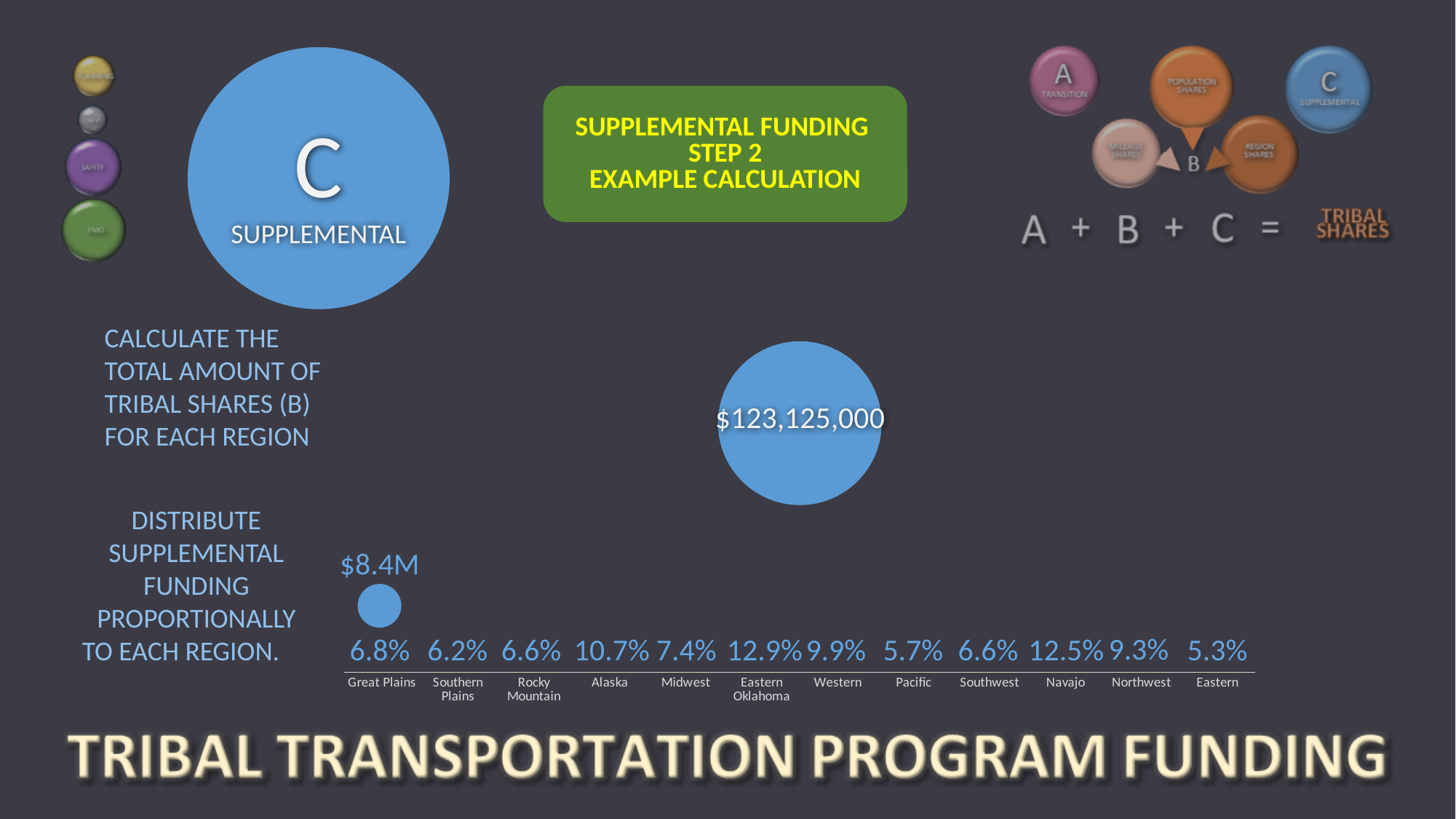
Which has a larger percentage, Midwest or Southern Plains? Midwest Which has a larger percentage, Northwest or Western? Western What is the difference between the percentages for Alaska and Great Plains? 3.9% How many regions are listed along the bottom of the regional distribution chart? 12 What percentage is shown for Pacific in the regional distribution chart? 5.7% What percentage is shown for Alaska in the regional distribution chart? 10.7% What percentage is shown for Western in the regional distribution chart? 9.9% What is the difference between the percentages for Eastern Oklahoma and Navajo? 0.4% What percentage is shown for Navajo in the regional distribution chart? 12.5% What dollar amount is labelled on the bubble above Great Plains? $8.4M Which region has the lowest percentage in the regional distribution chart? Eastern Which region has the highest percentage in the regional distribution chart? Eastern Oklahoma